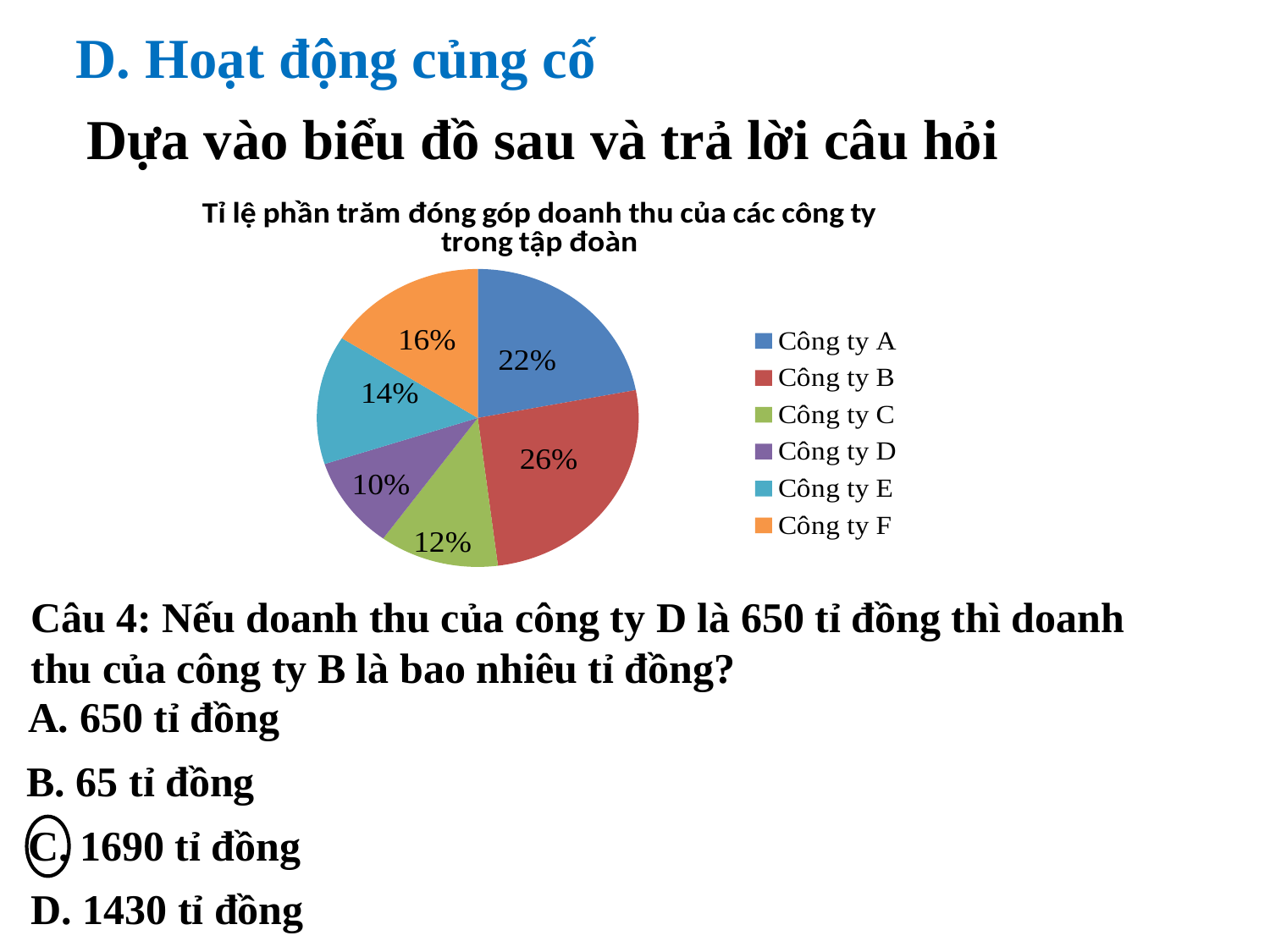
What is the title of the chart? Tỉ lệ phần trăm đóng góp doanh thu của các công ty trong tập đoàn What share of the pie does Công ty D have? 10% Which has a larger share, Công ty E or Công ty F? Công ty F What is the difference in percentage points between Công ty B and Công ty C? 14% Which company is shown in orange in the legend? Công ty F How many companies are shown in the pie chart? 6 Which company has the smallest slice of the pie? Công ty D What share of the pie does Công ty A have? 22% Which company has the largest slice of the pie? Công ty B What share of the pie does Công ty F have? 16% What kind of chart is shown on the slide? Pie chart